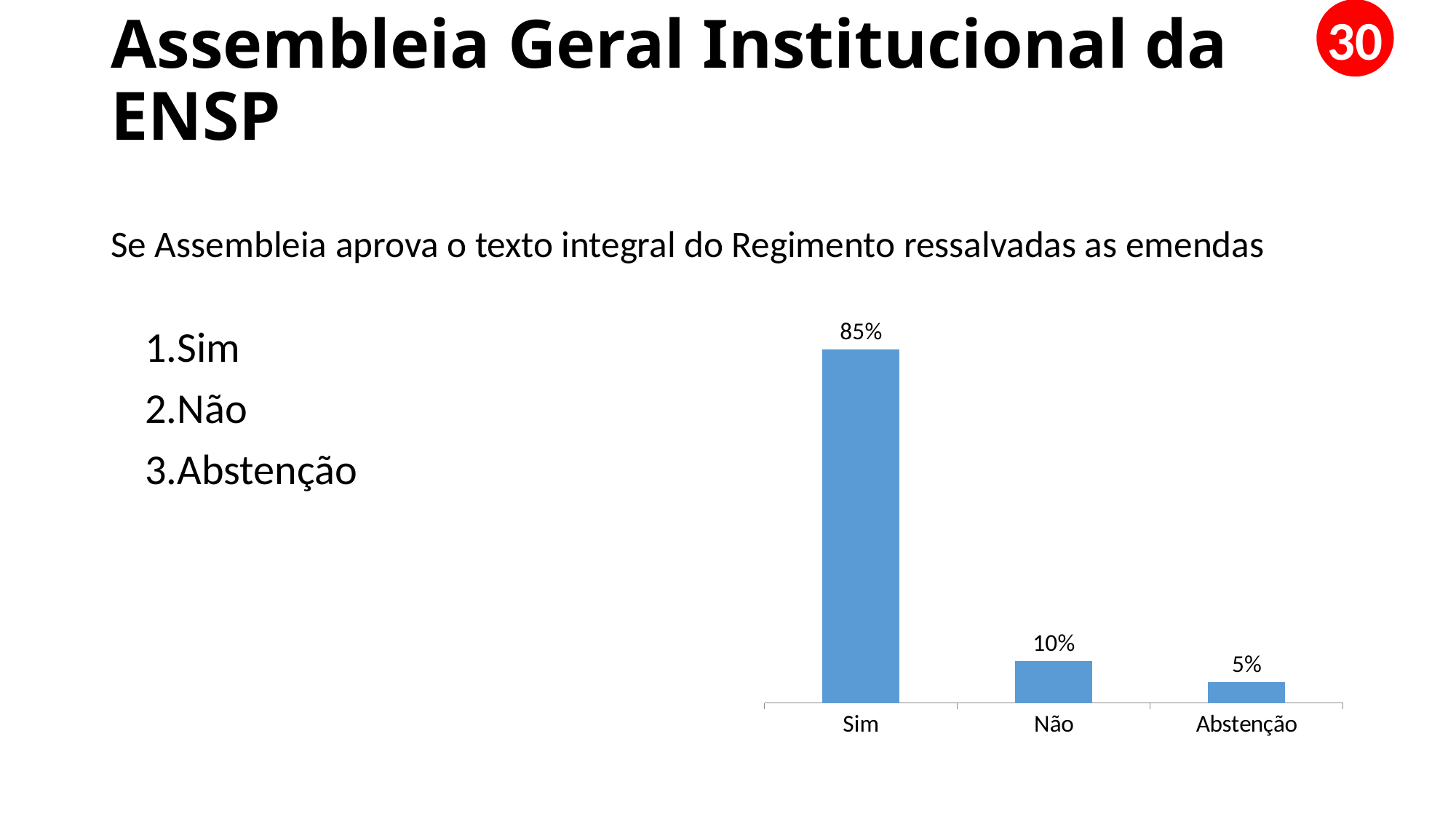
What kind of chart is shown on the slide? Bar chart What is the difference between the values for Não and Abstenção? 5% What is the value for Abstenção? 5% What is the value for Sim? 85% Which category has the lowest value? Abstenção How many categories are shown on the x axis? 3 What is the difference between the values for Sim and Não? 75% Do the values rise or fall from left to right along the x axis? Fall Which is larger, the value for Não or the value for Abstenção? Não What is the value for Não? 10% What colour are the bars in the chart? Blue Which category has the highest value? Sim